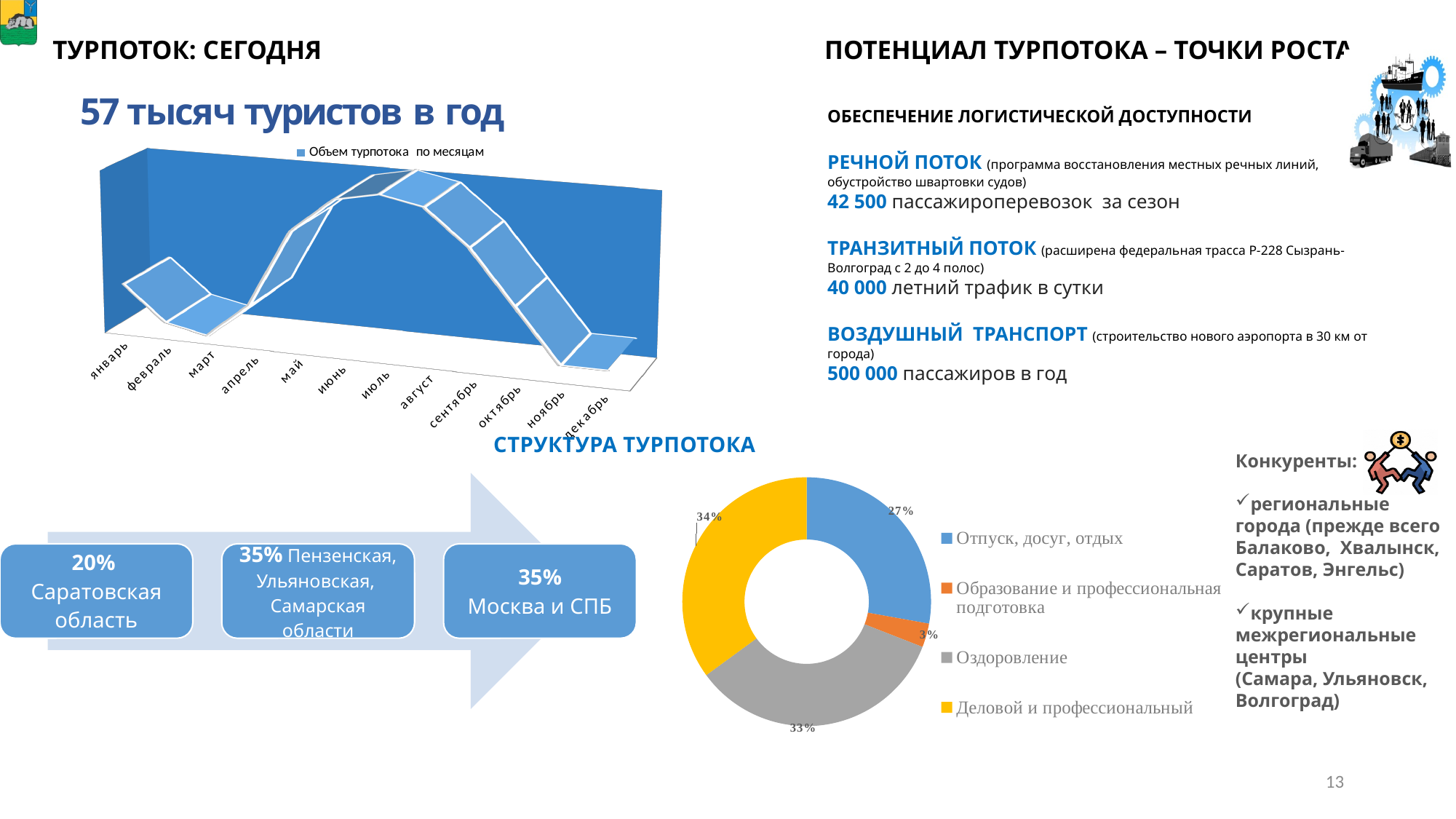
In the doughnut chart under СТРУКТУРА ТУРПОТОКА, what share is labelled for Образование и профессиональная подготовка? 3% How many series does the legend of the chart titled Объем турпотока по месяцам list? 1 In the doughnut chart under СТРУКТУРА ТУРПОТОКА, which is larger: Отпуск, досуг, отдых or Оздоровление? Оздоровление In the doughnut chart under СТРУКТУРА ТУРПОТОКА, which category has the largest share? Деловой и профессиональный In the doughnut chart under СТРУКТУРА ТУРПОТОКА, which category has the smallest share? Образование и профессиональная подготовка In the doughnut chart under СТРУКТУРА ТУРПОТОКА, what share is labelled for Деловой и профессиональный? 34% What kind of chart is shown under СТРУКТУРА ТУРПОТОКА? Doughnut chart In the doughnut chart under СТРУКТУРА ТУРПОТОКА, what share is labelled for Отпуск, досуг, отдых? 27% How many categories does the legend of the doughnut chart under СТРУКТУРА ТУРПОТОКА list? 4 How many months are shown on the x axis of the chart titled Объем турпотока по месяцам? 12 In the doughnut chart under СТРУКТУРА ТУРПОТОКА, what share is labelled for Оздоровление? 33% In the doughnut chart under СТРУКТУРА ТУРПОТОКА, what is the difference in percentage points between Оздоровление and Отпуск, досуг, отдых? 6